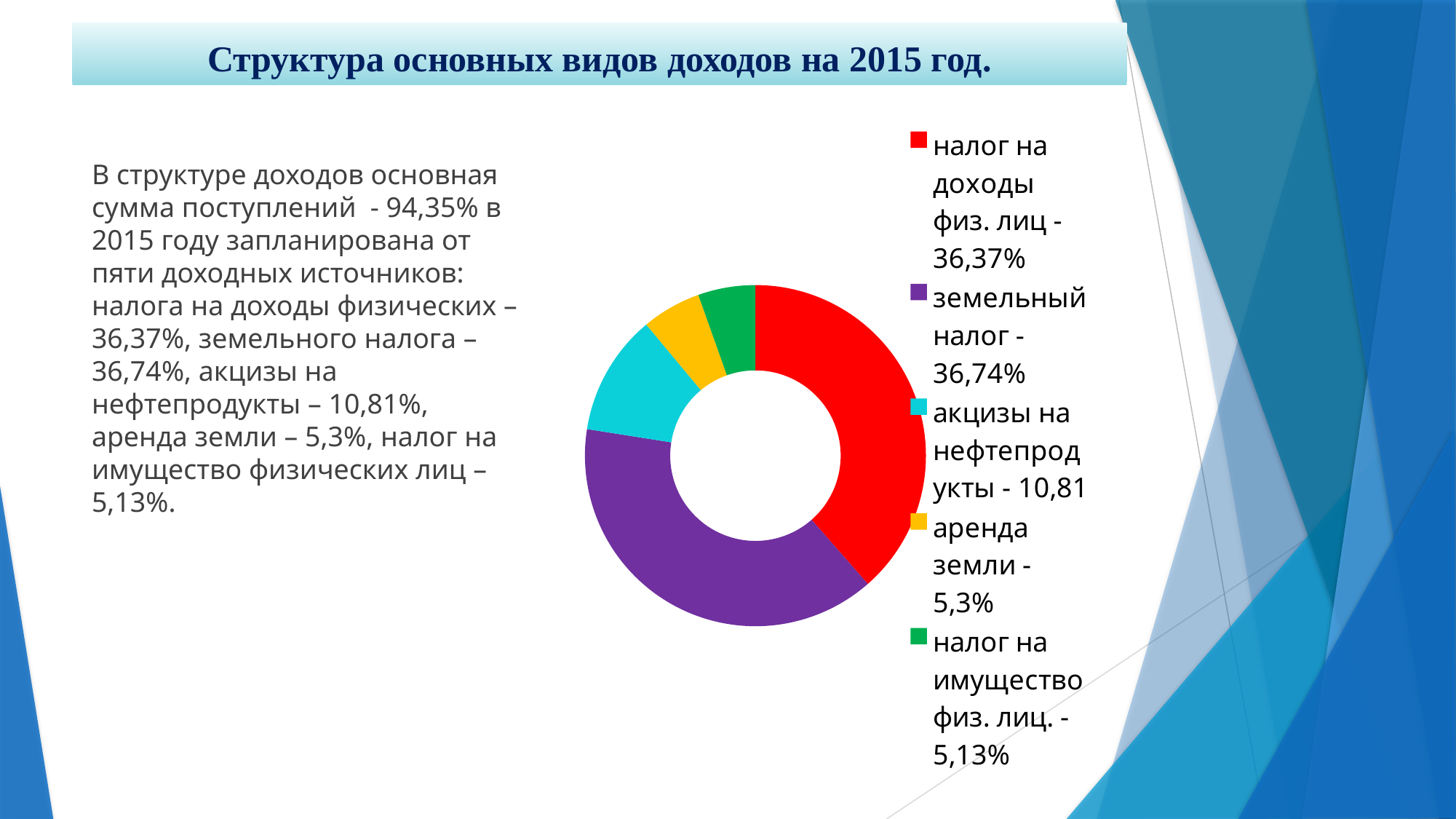
Which is larger: the share for акцизы на нефтепродукты or the share for аренда земли? акцизы на нефтепродукты By how many percentage points does земельный налог exceed налог на доходы физ. лиц? 0,37 What kind of chart is shown on the slide? doughnut (pie) chart What share does the legend give for земельный налог? 36,74% What colour represents налог на доходы физ. лиц in the chart? red What share does the legend give for налог на доходы физ. лиц? 36,37% What share does the legend give for аренда земли? 5,3% Which category has the largest share according to the legend values? земельный налог What value does the legend give for акцизы на нефтепродукты? 10,81 What share does the legend give for налог на имущество физ. лиц? 5,13% Which category has the smallest share according to the legend values? налог на имущество физ. лиц How many categories does the chart show? 5